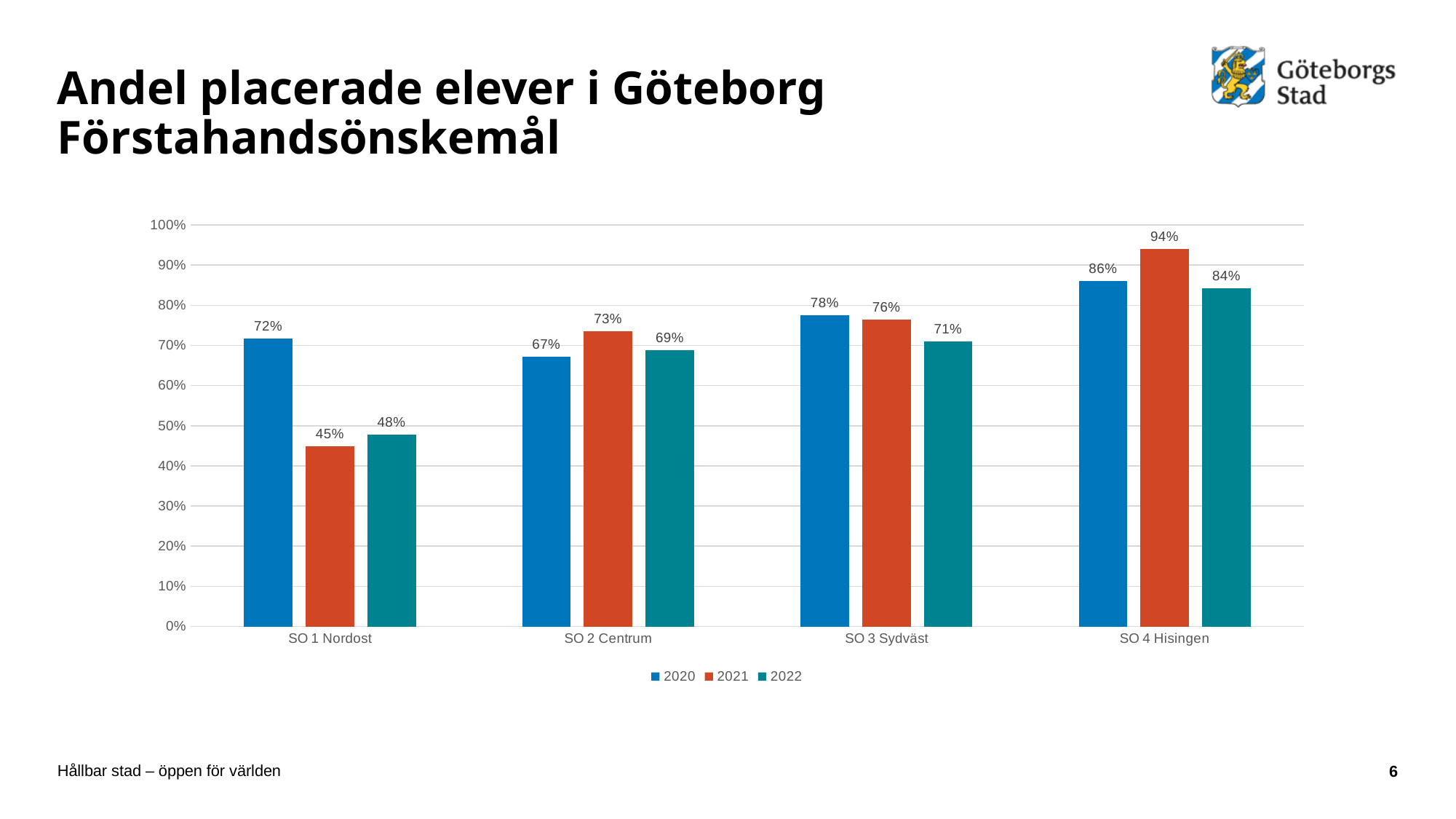
What is the value for SO 2 Centrum in 2022? 69% Which category has the highest value in 2021? SO 4 Hisingen What is the value for SO 4 Hisingen in 2021? 94% Which colour represents the 2021 series in the legend? Orange-red Which category has the lowest value in 2022? SO 1 Nordost What is the value for SO 1 Nordost in 2020? 72% What is the difference between the 2020 and 2021 values for SO 1 Nordost? 27 percentage points How many series does the legend list? 3 How many categories are shown on the x axis? 4 Which is larger for SO 3 Sydväst: the 2020 value or the 2022 value? 2020 What kind of chart is shown on the slide? Bar chart Is the value for SO 4 Hisingen in 2022 greater or less than 80%? greater